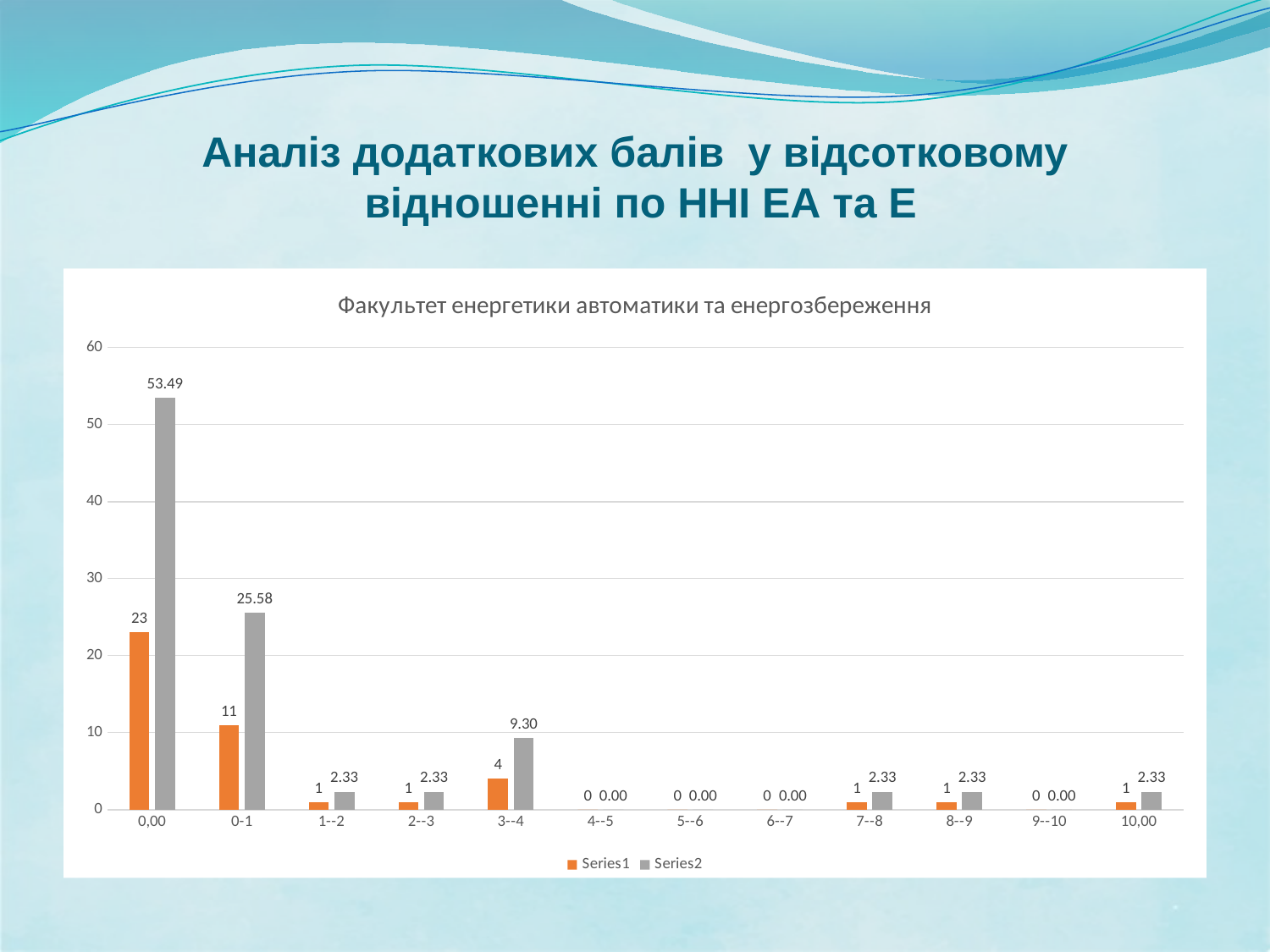
How many series does the legend list? 2 Which is larger: the Series1 value for 0,00 or the Series1 value for 0-1? 0,00 Is the Series2 value for 0,00 greater or less than 50? greater What is the Series2 value for the category 0,00? 53.49 What is the title of the chart? Факультет енергетики автоматики та енергозбереження What is the Series2 value for the category 3--4? 9.30 What is the difference between the Series2 values for 0,00 and 0-1? 27.91 What is the Series1 value for the category 3--4? 4 What kind of chart is shown on the slide? bar chart How many categories are shown on the x axis? 12 Which category has the highest Series2 value? 0,00 What is the Series1 value for the category 0-1? 11